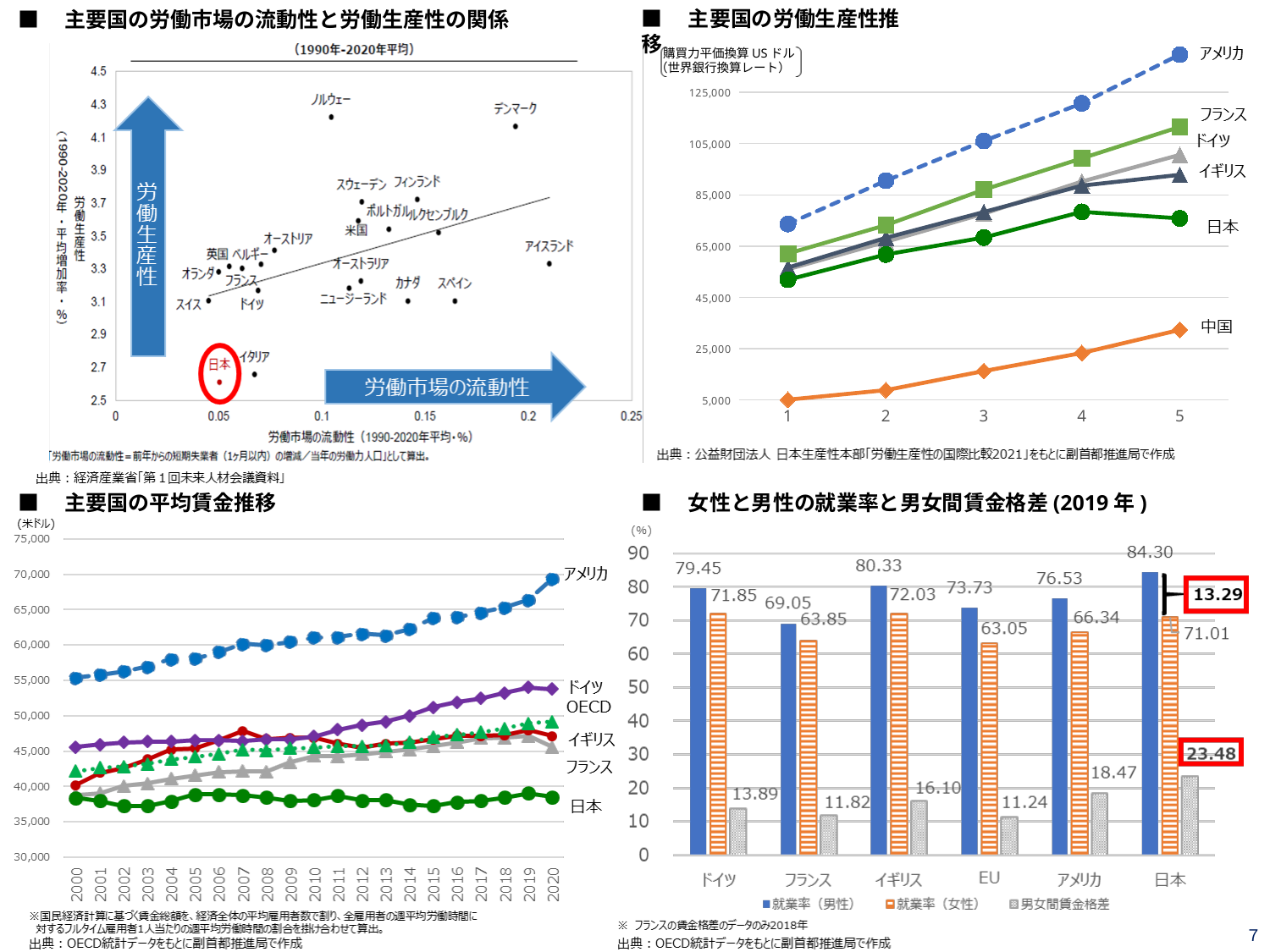
In the bottom-right chart (女性と男性の就業率と男女間賃金格差), what is the male employment rate (就業率（男性）) for 日本? 84.30 In the bottom-right chart (女性と男性の就業率と男女間賃金格差), which category has the lowest 男女間賃金格差? EU How many series does the legend of the bottom-right chart (女性と男性の就業率と男女間賃金格差) list? 3 How many countries/regions are shown on the x axis of the bottom-right chart (女性と男性の就業率と男女間賃金格差)? 6 In the bottom-right chart (女性と男性の就業率と男女間賃金格差), which country has the highest male employment rate (就業率（男性）)? 日本 In the bottom-right chart (女性と男性の就業率と男女間賃金格差), which has the higher female employment rate (就業率（女性）), ドイツ or イギリス? イギリス In the top-right chart (主要国の労働生産性推移), which country has the highest value at point 5? アメリカ In the bottom-left chart (主要国の平均賃金推移), is the value for 日本 in 2020 greater or less than 40,000? less In the bottom-right chart (女性と男性の就業率と男女間賃金格差), what is the 男女間賃金格差 value for アメリカ? 18.47 What kind of chart is the bottom-right chart (女性と男性の就業率と男女間賃金格差)? bar chart In the bottom-right chart (女性と男性の就業率と男女間賃金格差), what is the difference between the male and female employment rates for 日本? 13.29 In the top-right chart (主要国の労働生産性推移), is the value for 中国 at point 5 greater or less than 25,000? greater